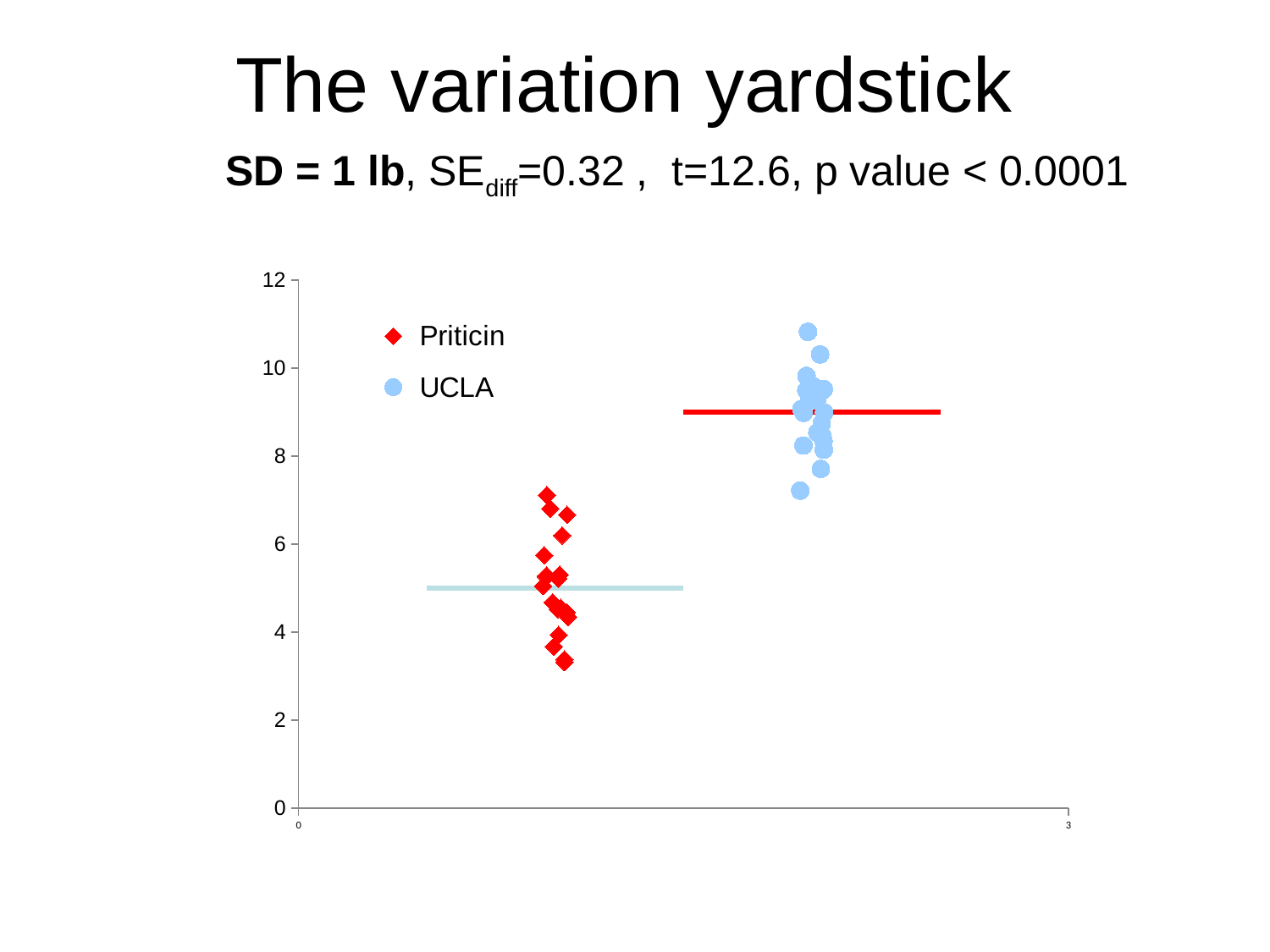
Is the horizontal line drawn through the UCLA points greater or less than 8? greater What kind of chart is shown on the slide? scatter chart Which series has the lower values overall, Priticin or UCLA? Priticin Which series is plotted with red diamond markers? Priticin What is the highest value labelled on the vertical axis? 12 Are the Priticin points greater or less than 8 on the vertical axis? less Which two series are listed in the chart legend? Priticin and UCLA Are the UCLA points greater or less than 6 on the vertical axis? greater Which series is plotted with light blue circle markers? UCLA How many series does the chart legend list? 2 Which series has the higher values overall, Priticin or UCLA? UCLA